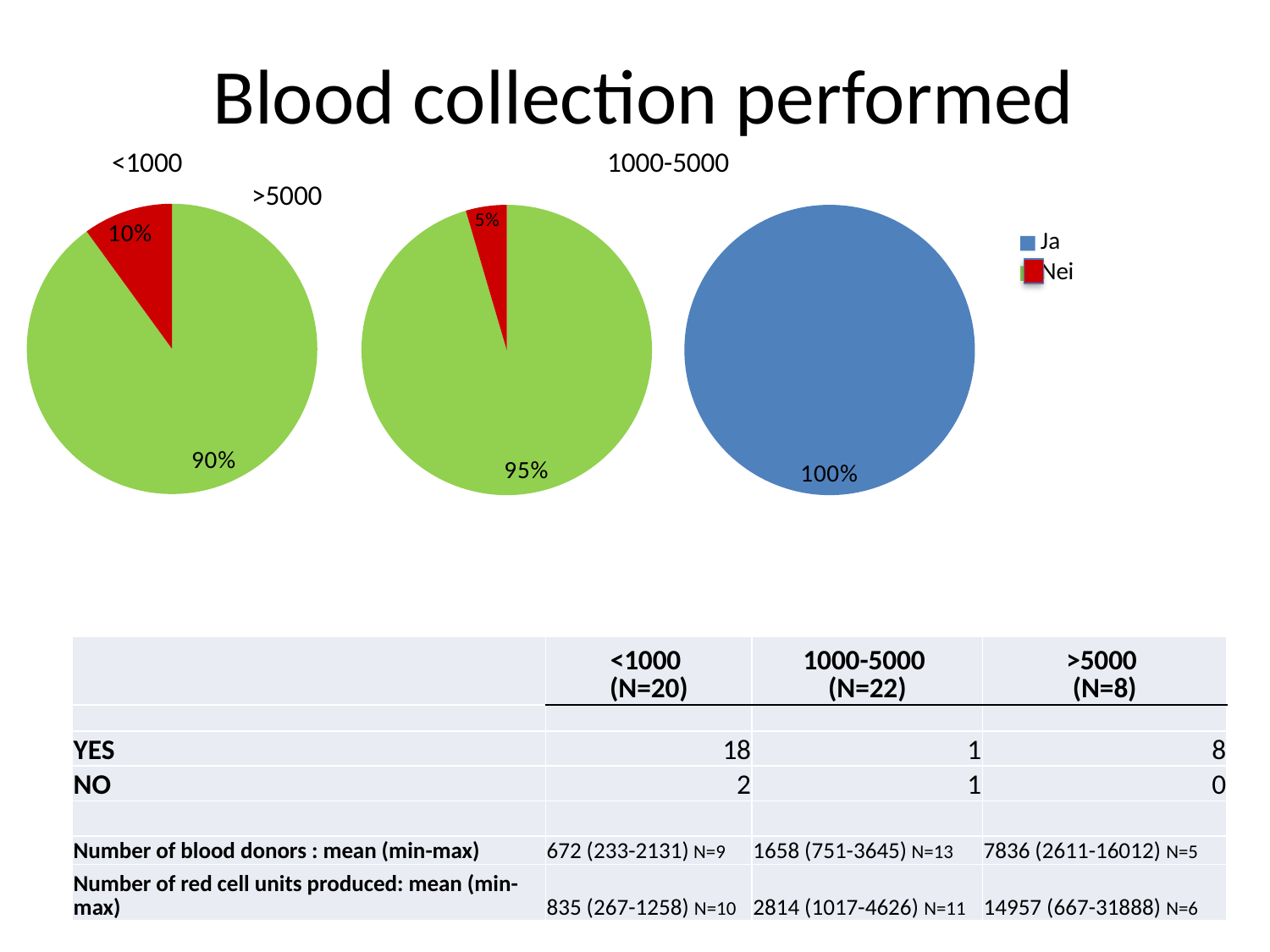
In the >5000 pie chart, what percentage label is shown? 100% What are the two entries in the legend? Ja and Nei How many entries does the legend list? 2 In the <1000 pie chart, what percentage is shown for the large green slice? 90% Which pie chart has the larger red slice, <1000 or 1000-5000? <1000 How many pie charts are on the slide? 3 What is the difference between the red slice percentages in the <1000 and 1000-5000 pie charts? 5% What is the title of the slide above the pie charts? Blood collection performed In the 1000-5000 pie chart, what percentage is shown for the large green slice? 95% In the <1000 pie chart, what percentage is shown for the red slice? 10% In the 1000-5000 pie chart, what percentage is shown for the red slice? 5% What kind of charts are shown on the slide? Pie charts